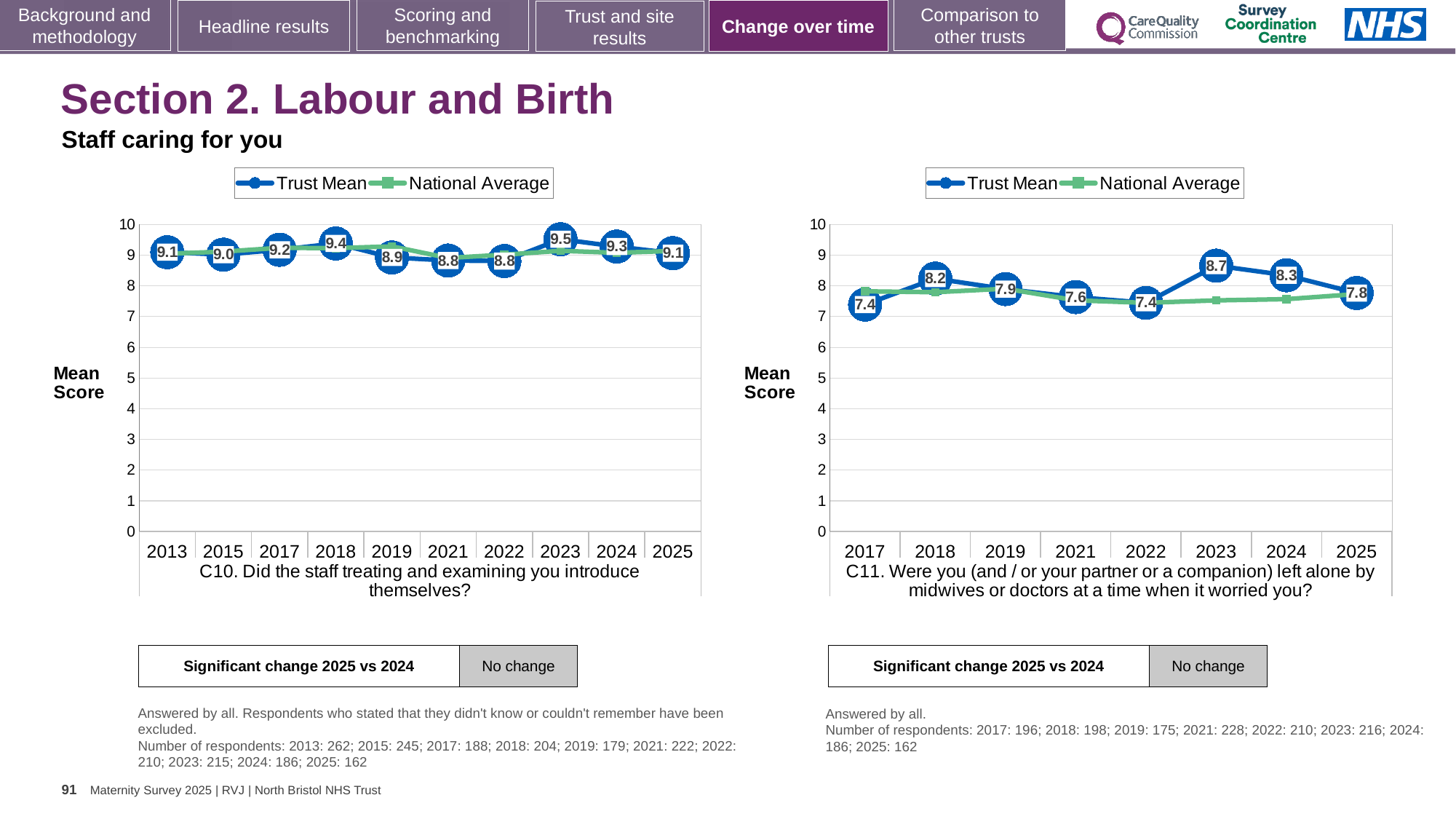
In the C11 chart, what is the difference between the Trust Mean for 2023 and the Trust Mean for 2024? 0.4 In the C10 chart, what is the difference between the Trust Mean for 2023 and the Trust Mean for 2021? 0.7 In the C11 chart, how many series does the legend list? 2 In the C11 chart, which year has the highest Trust Mean? 2023 In the C11 chart, is the Trust Mean for 2018 or 2021 larger? 2018 In the C10 chart, how many years are shown on the x axis? 10 In the C10 chart, what is the Trust Mean for 2019? 8.9 In the C10 chart, which year has the highest Trust Mean? 2023 In the C10 chart, what is the Trust Mean for 2023? 9.5 In the C11 chart, what is the Trust Mean for 2023? 8.7 What kind of chart is the C10 chart? Line chart In the C11 chart, what is the Trust Mean for 2025? 7.8